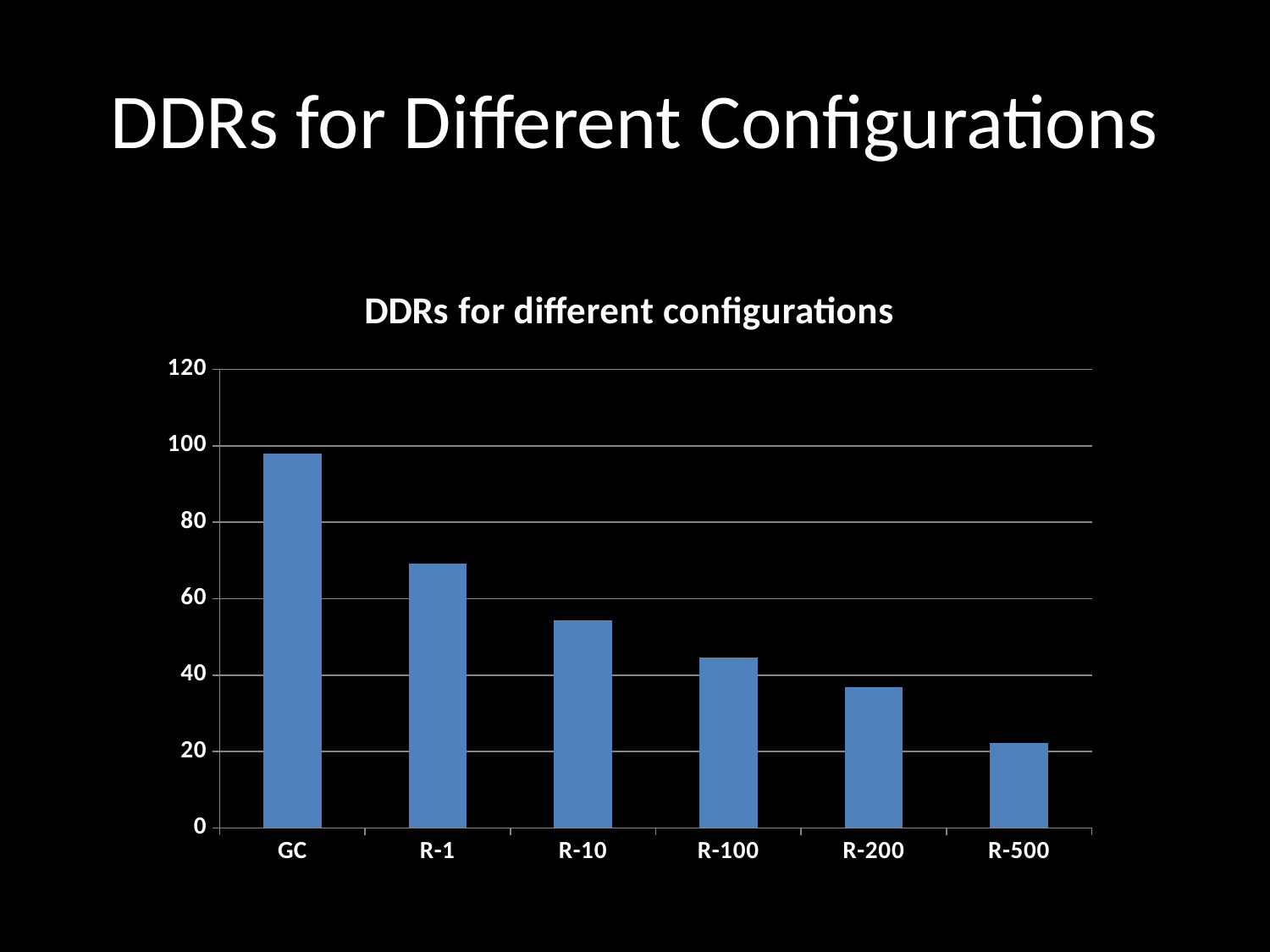
What kind of chart is shown on the slide? bar chart Which configuration has the highest DDR value? GC Is the value for GC greater or less than 80? greater Which has a larger value, R-100 or R-500? R-100 Is the value for R-1 greater or less than 60? greater Is the value for R-500 greater or less than 40? less What is the title of the chart? DDRs for different configurations Which configuration has the lowest DDR value? R-500 Do the values rise or fall moving from GC to R-500 along the x axis? fall How many configurations are plotted on the x axis? 6 Which has a larger value, R-1 or R-10? R-1